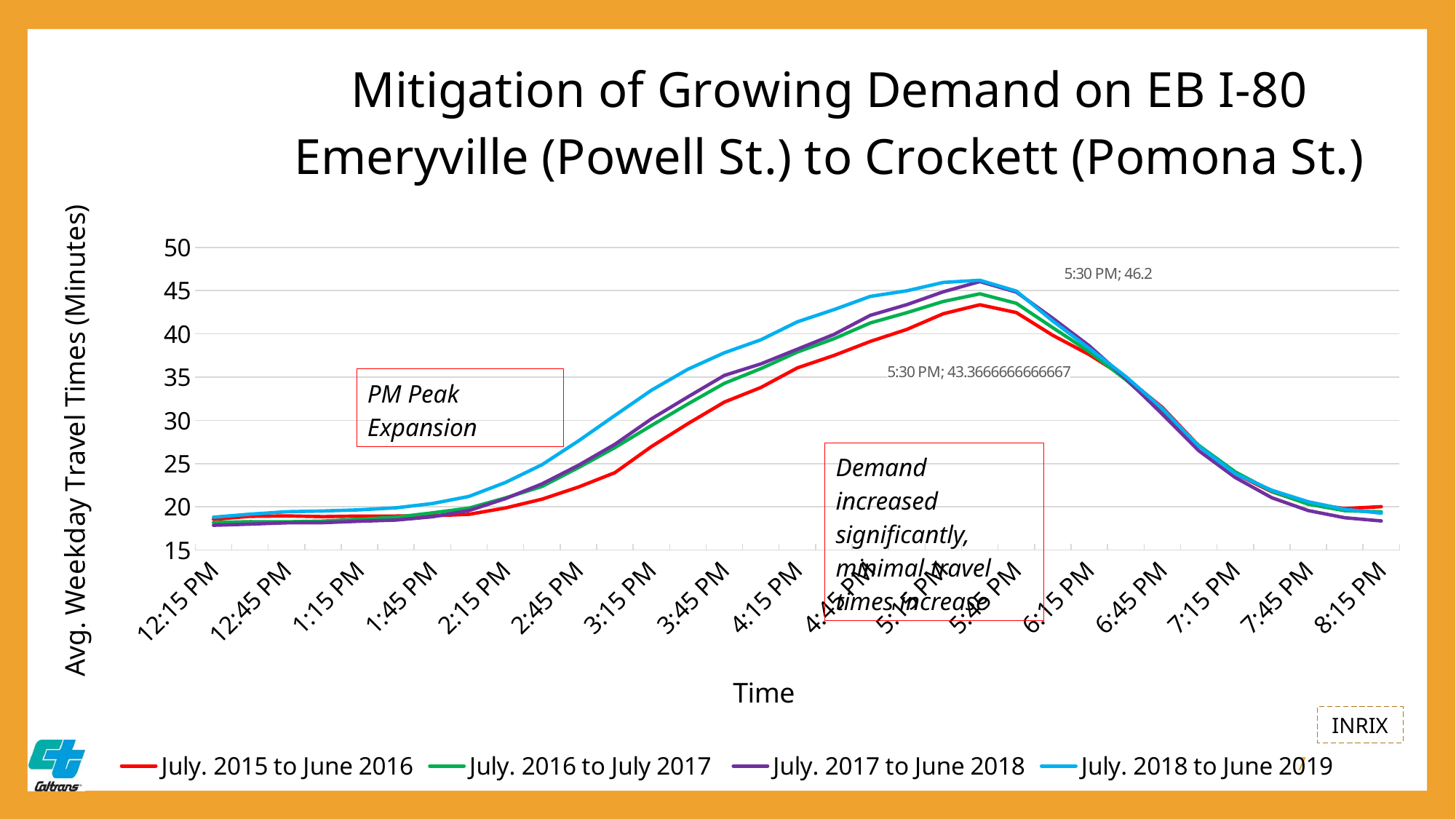
How many series does the legend list? 4 Do the travel times rise or fall between 12:15 PM and 5:30 PM? rise What is the labelled peak travel time for the July 2018 to June 2019 series at 5:30 PM? 46.2 What is the labelled travel time for the July 2015 to June 2016 series at 5:30 PM? 43.3666666666667 Is the value for July 2017 to June 2018 at 8:15 PM greater or less than 20? less At what time do the labelled peak values occur? 5:30 PM Is the value for July 2018 to June 2019 at 4:15 PM greater or less than 35? greater Is the value for July 2015 to June 2016 at 4:15 PM greater or less than 35? greater Which series reaches the highest peak travel time? July. 2018 to June 2019 At 3:15 PM, which series has the larger travel time: July 2015 to June 2016 or July 2018 to June 2019? July. 2018 to June 2019 What is the title of the vertical axis? Avg. Weekday Travel Times (Minutes) What type of chart is shown on the slide? line chart